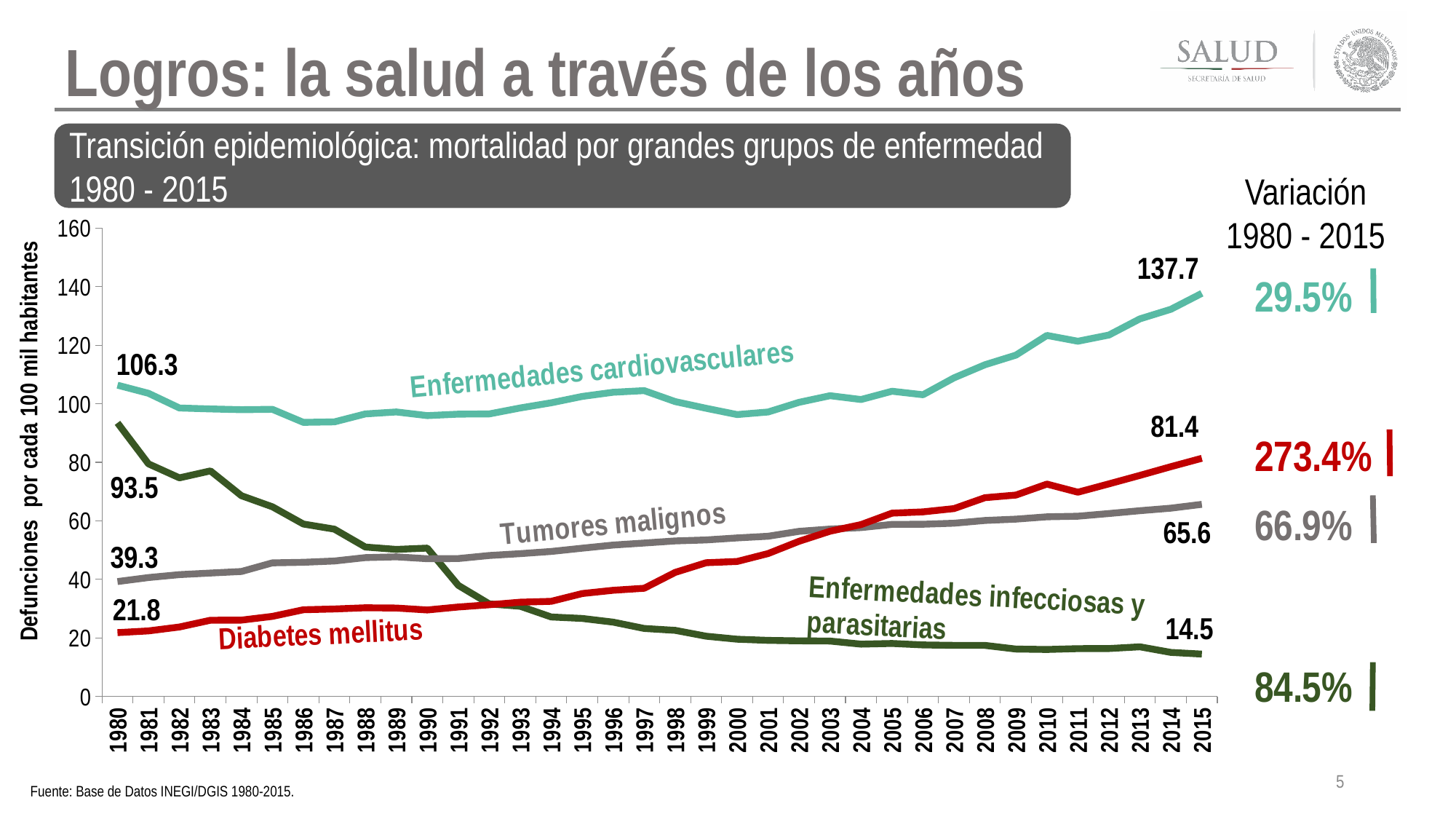
Which disease group had the highest mortality rate in 2015? Enfermedades cardiovasculares Is the mortality rate for Tumores malignos in 2000 greater or less than 60? less Does the mortality rate for Enfermedades infecciosas y parasitarias rise or fall from 1980 to 2015? fall Which disease group had the lowest mortality rate in 1980? Diabetes mellitus What was the mortality rate for Diabetes mellitus in 2015? 81.4 What was the mortality rate for Tumores malignos in 2015? 65.6 What is the 1980-2015 variation shown for Diabetes mellitus? 273.4% What type of chart is shown on the slide? line chart By how much did the mortality rate for Diabetes mellitus increase from 1980 (21.8) to 2015 (81.4)? 59.6 What was the mortality rate for Enfermedades infecciosas y parasitarias in 1980? 93.5 What was the mortality rate for Enfermedades cardiovasculares in 2015? 137.7 What was the mortality rate for Enfermedades cardiovasculares in 1980? 106.3